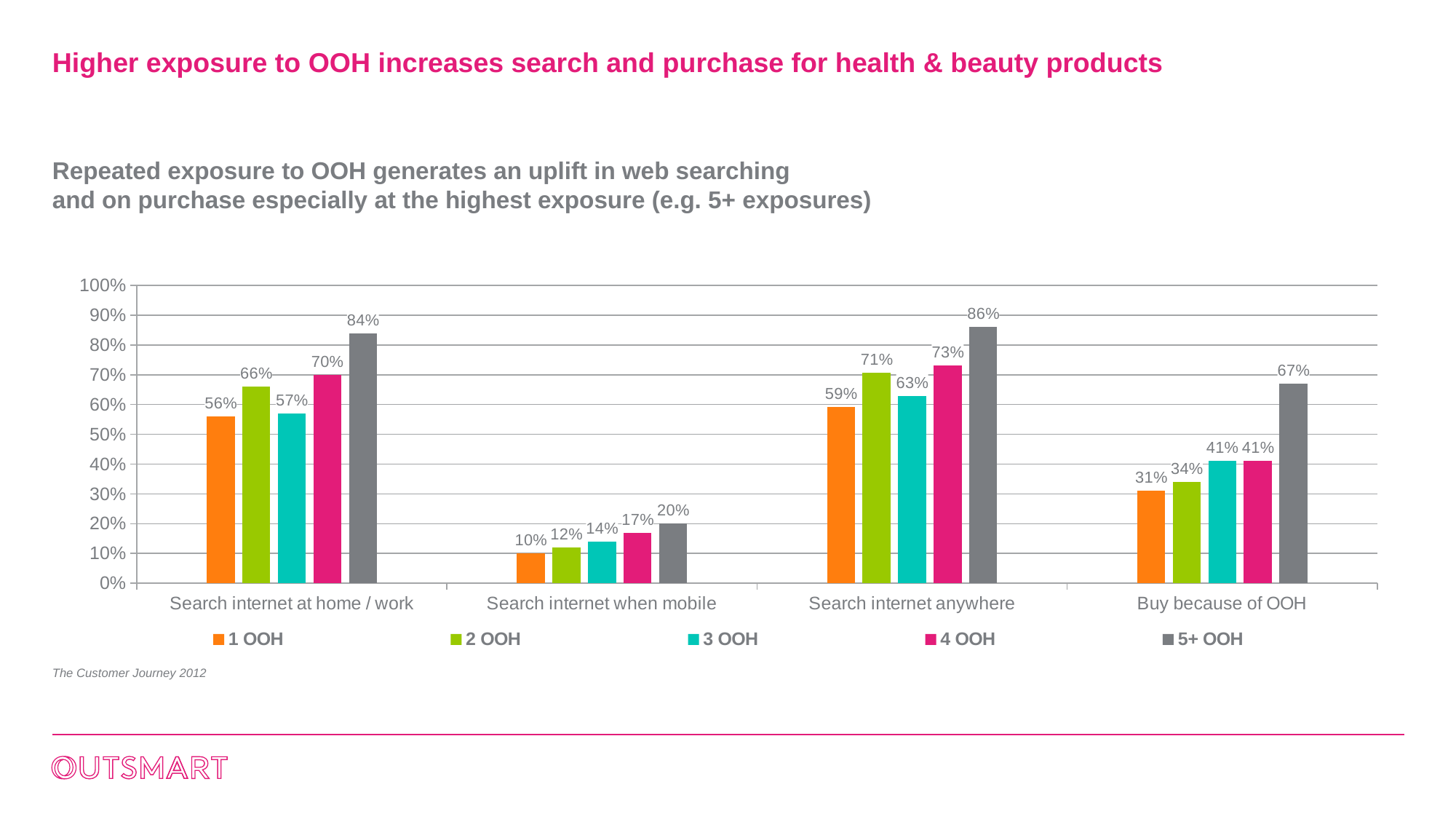
How many categories are shown on the x axis? 4 What kind of chart is shown on the slide? Bar chart How many series does the legend list? 5 Which legend entry is shown in grey? 5+ OOH Which category has the highest value for 5+ OOH? Search internet anywhere What is the value for 1 OOH in the Search internet when mobile category? 10% Which is larger in the Search internet at home / work category: 2 OOH or 3 OOH? 2 OOH What is the value for 5+ OOH in the Search internet at home / work category? 84% What is the value for 3 OOH in the Search internet anywhere category? 63% What is the difference between the 5+ OOH and 1 OOH values in the Buy because of OOH category? 36% Which category has the lowest value for 1 OOH? Search internet when mobile What is the value for 2 OOH in the Buy because of OOH category? 34%